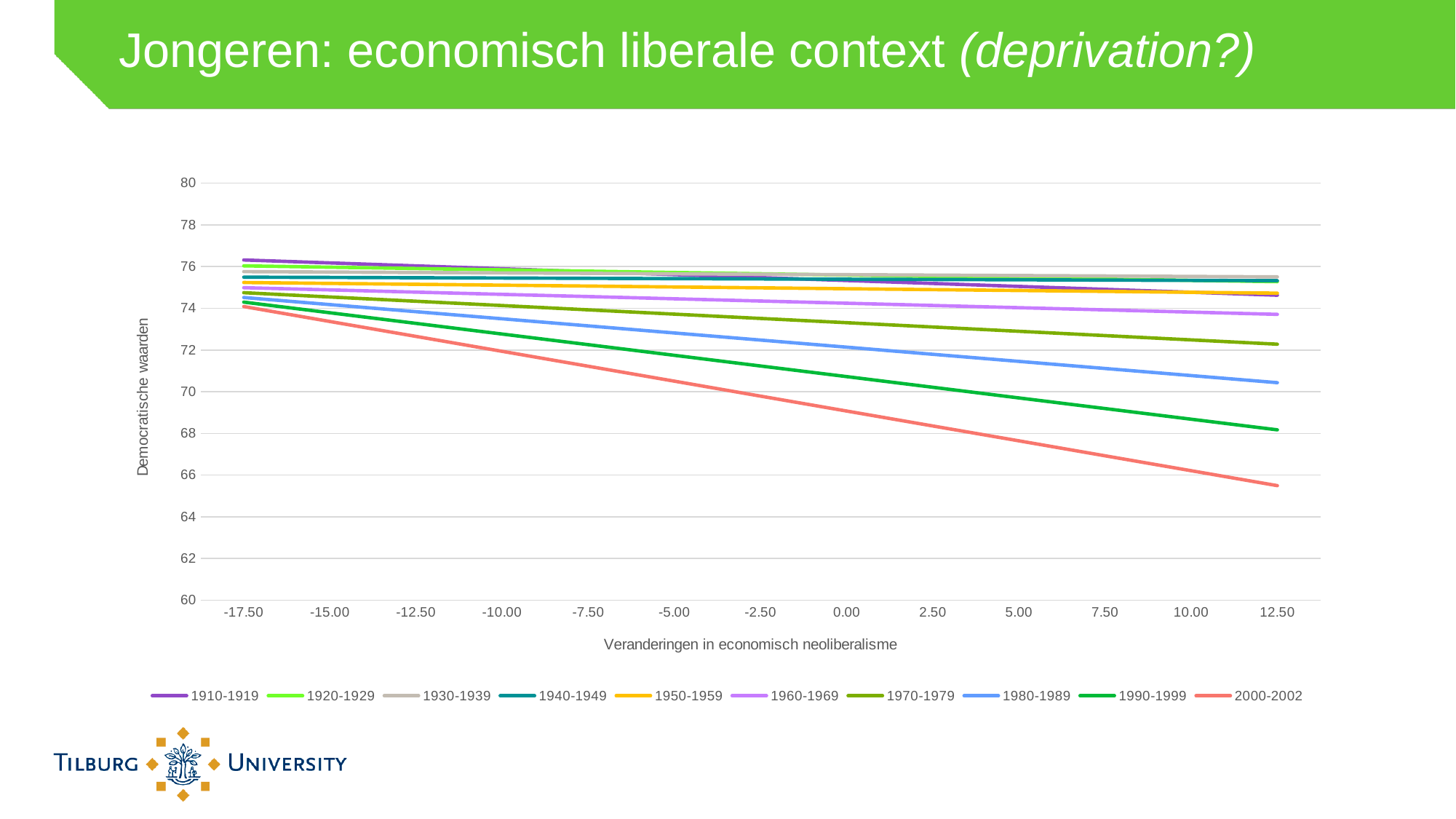
At x = 12.50, is the value for 1990-1999 greater or less than 66? greater How many tick values are shown along the x axis? 13 At x = 12.50, which is larger: the value for 1970-1979 or the value for 1980-1989? 1970-1979 At x = 12.50, is the value for 1980-1989 greater or less than 72? less At x = 12.50, which is larger: the value for 1910-1919 or the value for 2000-2002? 1910-1919 Do the values for the 2000-2002 series rise or fall as the x axis increases? fall At x = 12.50, is the value for 2000-2002 greater or less than 68? less What kind of chart is shown on the slide? line chart How many series does the legend list? 10 Which series has the lowest value at x = 12.50? 2000-2002 Do the values for the 1910-1919 series rise or fall as the x axis increases? fall What is the title of the y axis? Democratische waarden